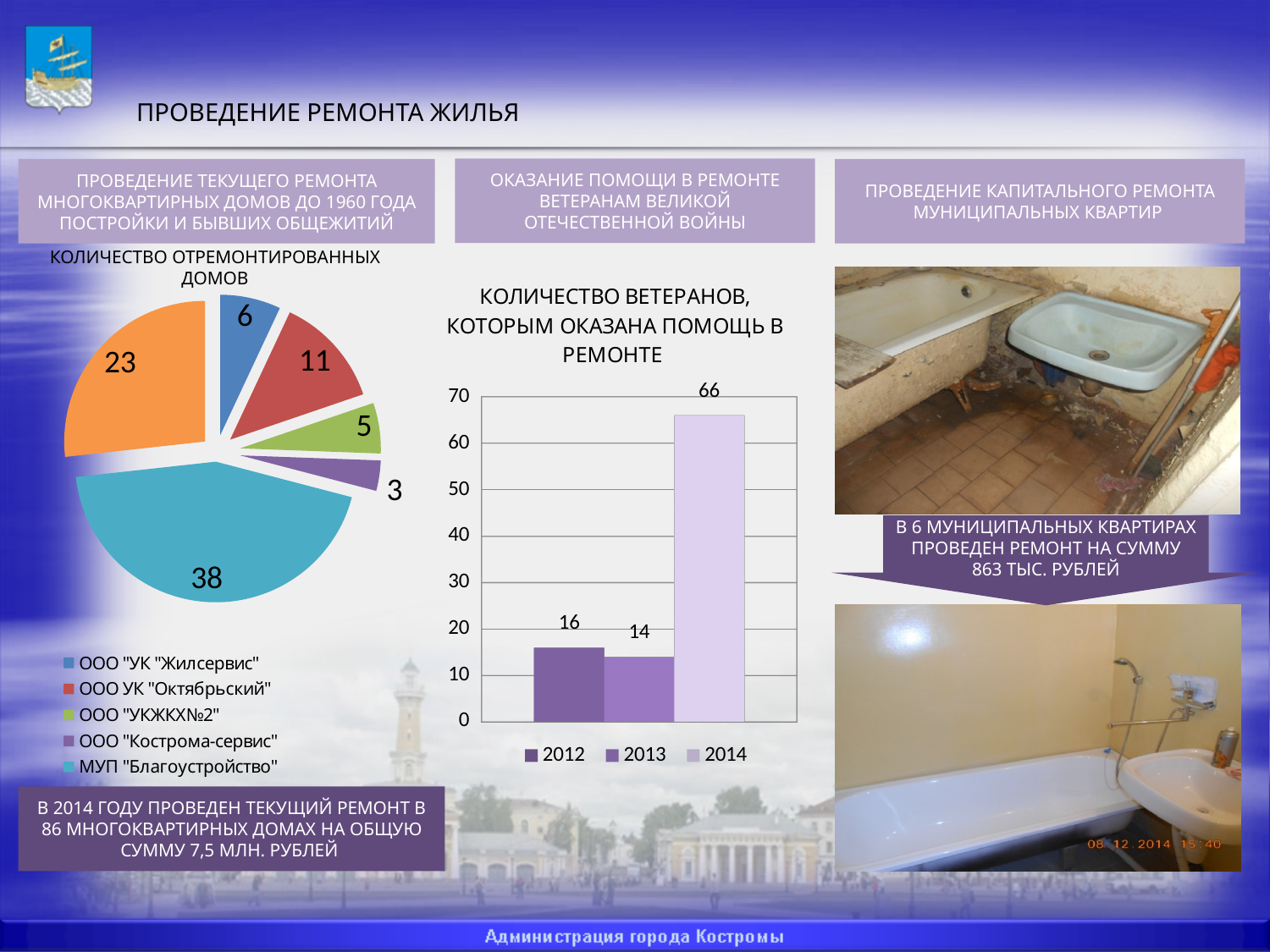
In the chart "КОЛИЧЕСТВО ВЕТЕРАНОВ, КОТОРЫМ ОКАЗАНА ПОМОЩЬ В РЕМОНТЕ", what is the value for 2012? 16 In the chart "КОЛИЧЕСТВО ВЕТЕРАНОВ, КОТОРЫМ ОКАЗАНА ПОМОЩЬ В РЕМОНТЕ", which year has the larger value, 2012 or 2013? 2012 What type of chart is "КОЛИЧЕСТВО ВЕТЕРАНОВ, КОТОРЫМ ОКАЗАНА ПОМОЩЬ В РЕМОНТЕ"? Bar chart In the pie chart "КОЛИЧЕСТВО ОТРЕМОНТИРОВАННЫХ ДОМОВ", what is the value for ООО УК "Октябрьский"? 11 In the pie chart "КОЛИЧЕСТВО ОТРЕМОНТИРОВАННЫХ ДОМОВ", which category has the smallest slice? ООО "Кострома-сервис" In the pie chart "КОЛИЧЕСТВО ОТРЕМОНТИРОВАННЫХ ДОМОВ", what is the difference between the values for ООО "УК "Жилсервис" and ООО "УКЖКХ№2"? 1 In the pie chart "КОЛИЧЕСТВО ОТРЕМОНТИРОВАННЫХ ДОМОВ", what is the value for МУП "Благоустройство"? 38 How many series does the legend of the chart "КОЛИЧЕСТВО ВЕТЕРАНОВ, КОТОРЫМ ОКАЗАНА ПОМОЩЬ В РЕМОНТЕ" list? 3 In the chart "КОЛИЧЕСТВО ВЕТЕРАНОВ, КОТОРЫМ ОКАЗАНА ПОМОЩЬ В РЕМОНТЕ", what is the value for 2014? 66 In the pie chart "КОЛИЧЕСТВО ОТРЕМОНТИРОВАННЫХ ДОМОВ", which legend category has the largest slice? МУП "Благоустройство" In the chart "КОЛИЧЕСТВО ВЕТЕРАНОВ, КОТОРЫМ ОКАЗАНА ПОМОЩЬ В РЕМОНТЕ", what is the difference between the values for 2014 and 2013? 52 What type of chart is "КОЛИЧЕСТВО ОТРЕМОНТИРОВАННЫХ ДОМОВ"? Pie chart